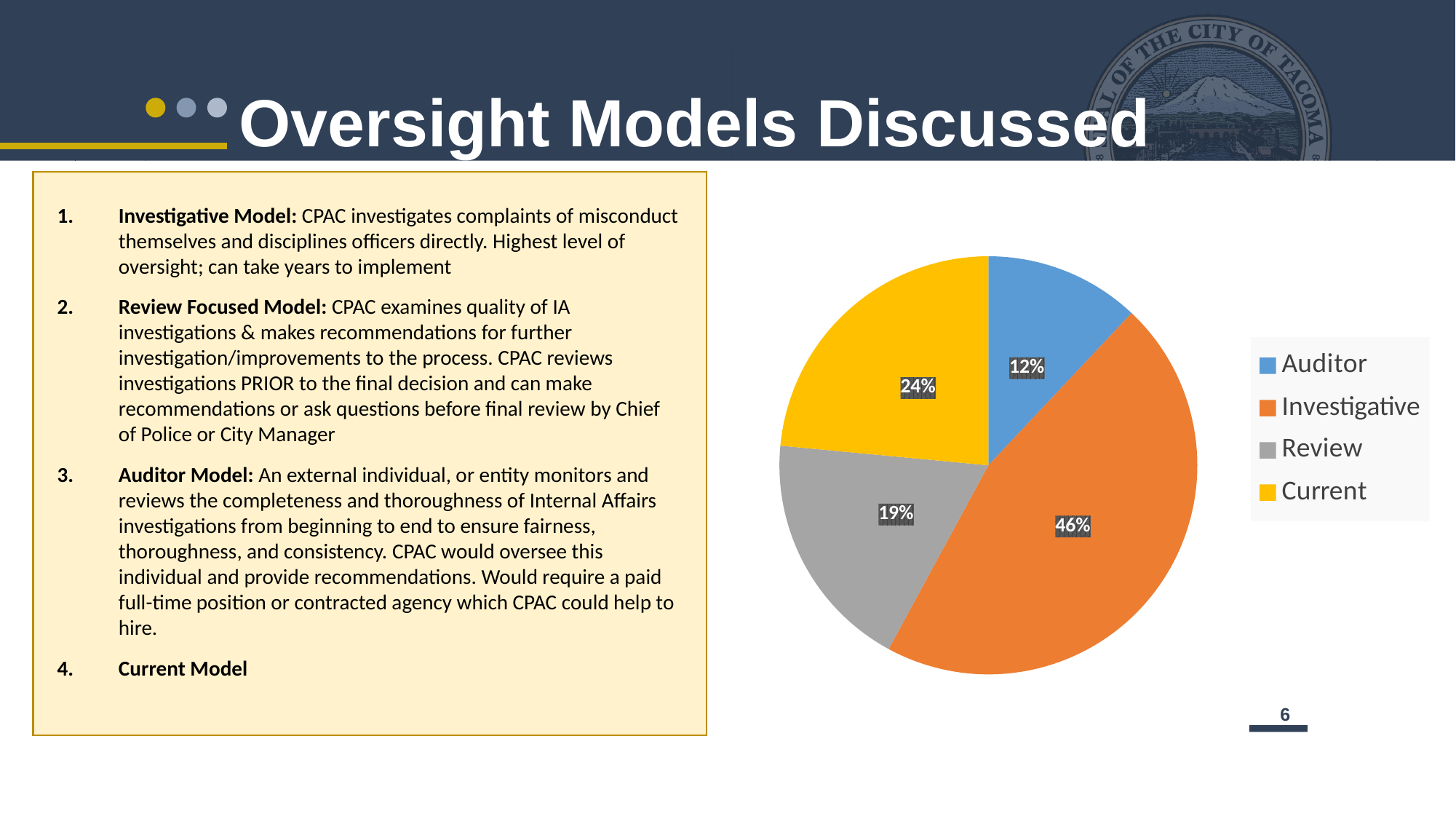
Which category has the smallest slice of the pie? Auditor Which legend entry is listed last? Current What is the difference in percentage points between the Investigative and Current slices? 22 What share of the pie does the Investigative slice represent? 46% What colour is the Investigative slice in the pie chart? orange Which category has the largest slice of the pie? Investigative Which slice is larger, Review or Current? Current What share of the pie does the Current slice represent? 24% What share of the pie does the Auditor slice represent? 12% How many categories does the pie chart show? 4 What share of the pie does the Review slice represent? 19% What kind of chart is shown on the slide? pie chart